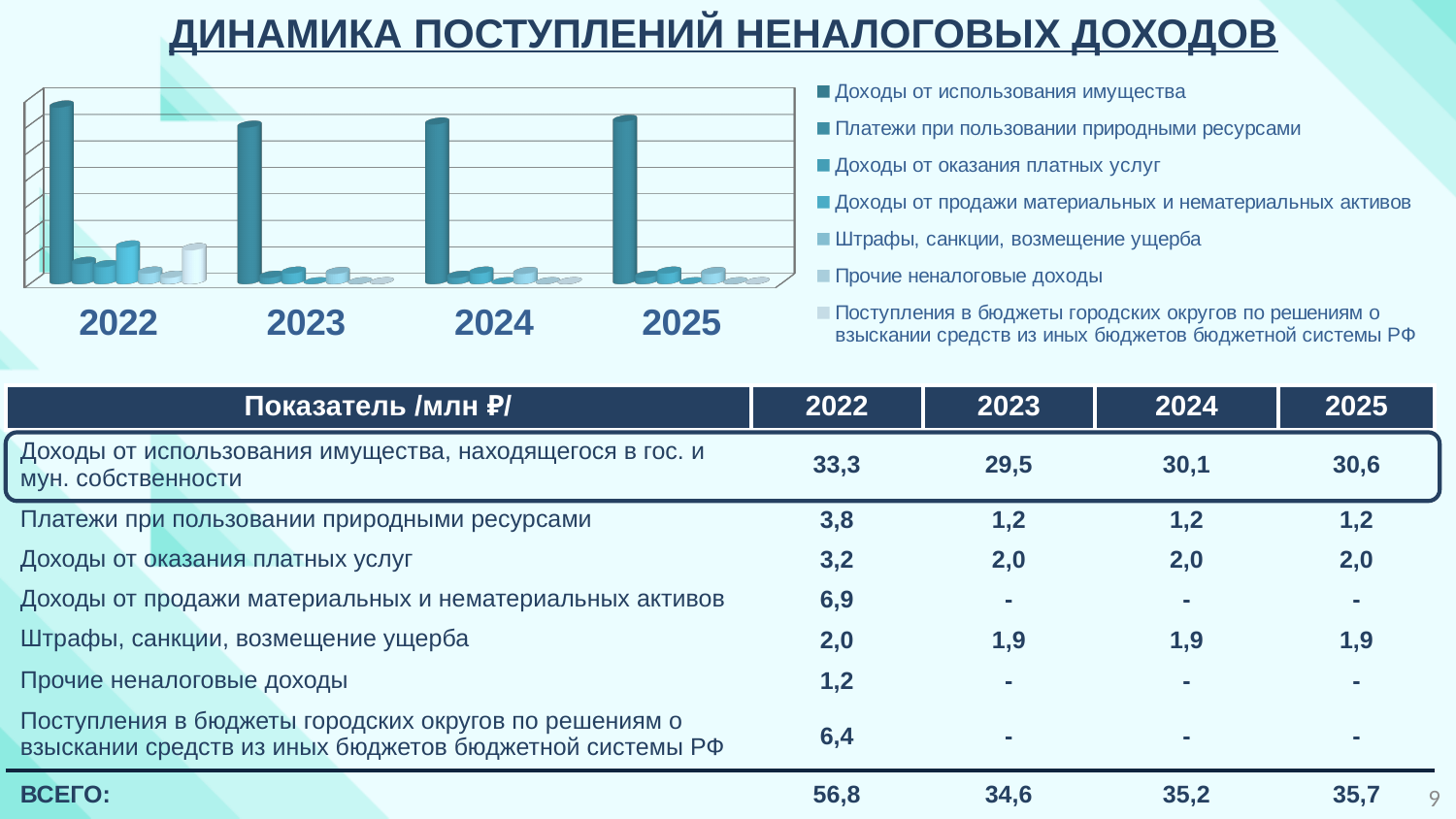
What is the title of the chart on the slide? ДИНАМИКА ПОСТУПЛЕНИЙ НЕНАЛОГОВЫХ ДОХОДОВ Which is larger in 2022: Доходы от продажи материальных и нематериальных активов or Доходы от оказания платных услуг? Доходы от продажи материальных и нематериальных активов In which year is the bar for Доходы от использования имущества the tallest? 2022 What is the value of Штрафы, санкции, возмещение ущерба for 2024, in млн ₽? 1,9 How many series does the chart legend list? 7 What kind of chart is shown on the slide? Bar chart What is the total (ВСЕГО) of all non-tax revenues for 2022, in млн ₽? 56,8 What is the difference between the 2022 and 2023 values of Доходы от использования имущества, in млн ₽? 3,8 How many years (categories) are shown along the x axis of the chart? 4 Which series has the tallest bar in every year of the chart? Доходы от использования имущества What is the value of Платежи при пользовании природными ресурсами for 2022, in млн ₽? 3,8 What is the value of Доходы от использования имущества for 2022, in млн ₽? 33,3